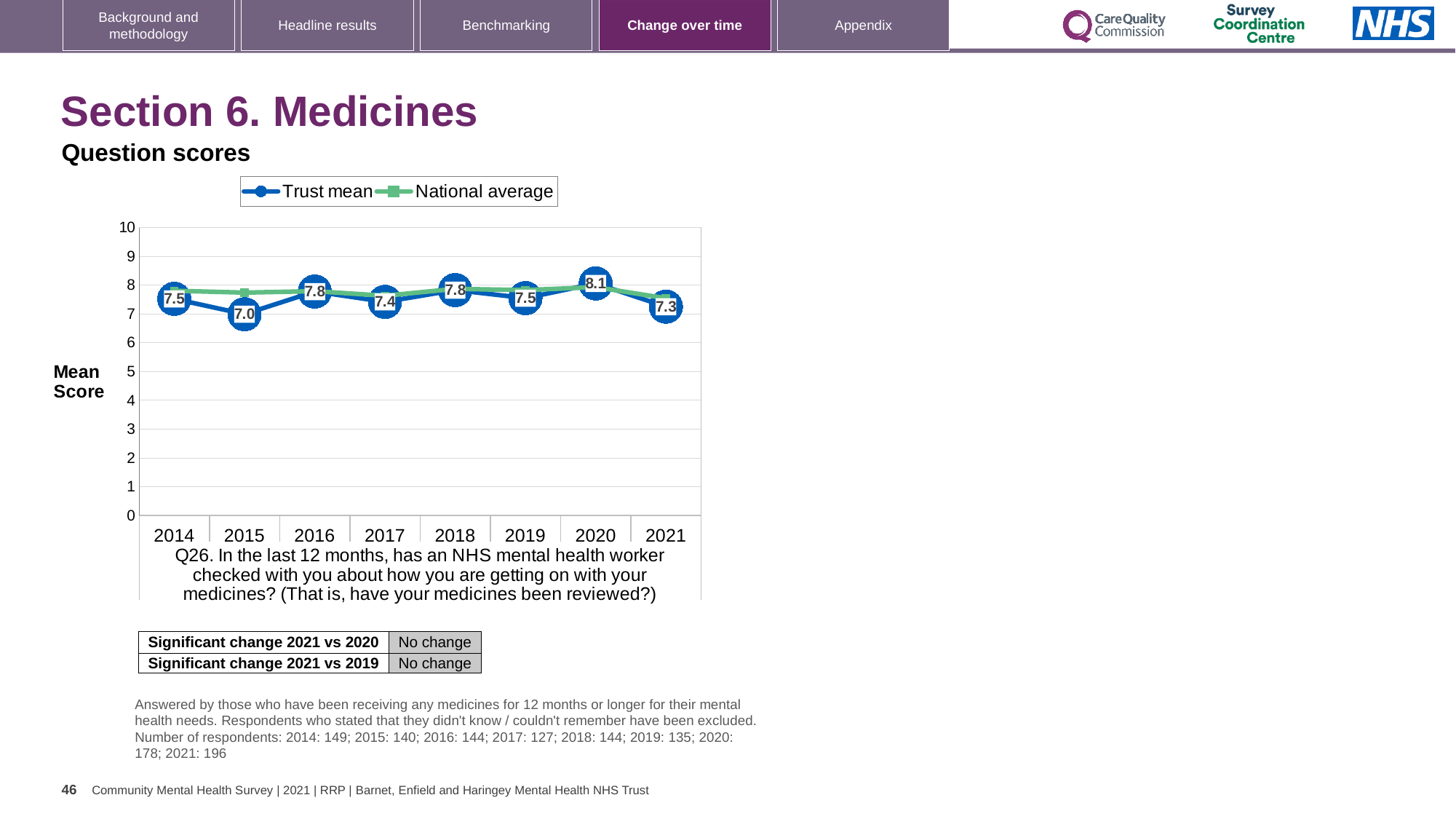
What is the difference between the Trust mean scores for 2020 and 2021? 0.8 What is the Trust mean score for 2020? 8.1 Which year has the larger Trust mean score, 2016 or 2017? 2016 How many series does the legend list? 2 Does the Trust mean score rise or fall from 2020 to 2021? Fall What kind of chart is shown on the slide? Line chart Is the National average value for 2021 greater or less than 6? greater What is the Trust mean score for 2021? 7.3 How many years are shown on the x axis of the chart? 8 In which year is the Trust mean score lowest? 2015 In which year is the Trust mean score highest? 2020 What is the Trust mean score for 2015? 7.0